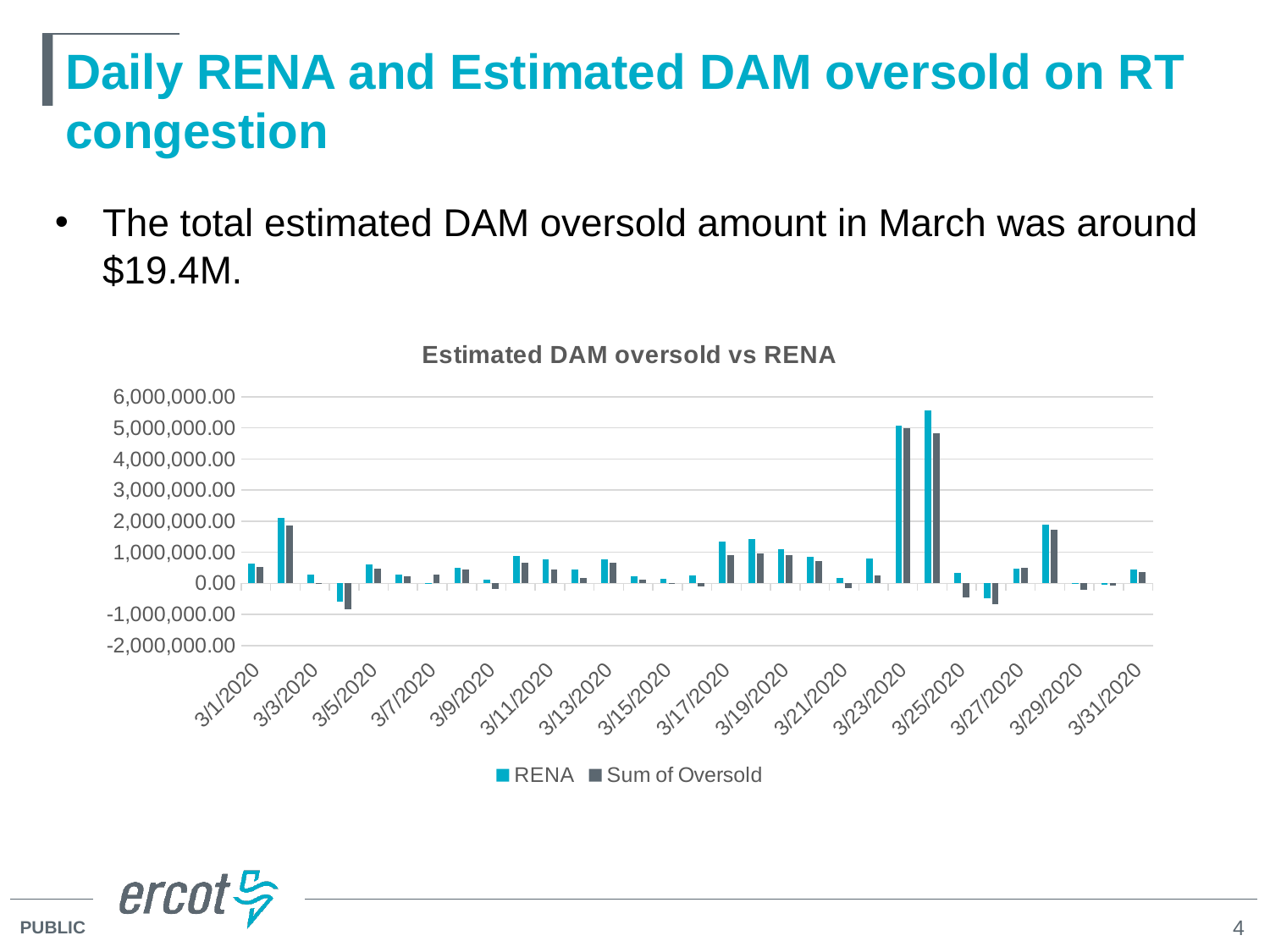
What type of chart is shown on the slide? Bar chart Is the RENA value for 3/31/2020 greater or less than 1,000,000.00? less What is the title of the chart? Estimated DAM oversold vs RENA Is the Sum of Oversold value for 3/23/2020 greater or less than 4,000,000.00? greater How many series does the chart legend list? 2 Is the RENA value for 3/23/2020 greater or less than 4,000,000.00? greater Which date has the larger RENA value, 3/1/2020 or 3/23/2020? 3/23/2020 What is the highest value shown on the y axis of the chart? 6,000,000.00 What are the two series named in the chart legend? RENA and Sum of Oversold How many date labels are shown on the x axis of the chart? 16 Which date has the larger Sum of Oversold value, 3/31/2020 or 3/23/2020? 3/23/2020